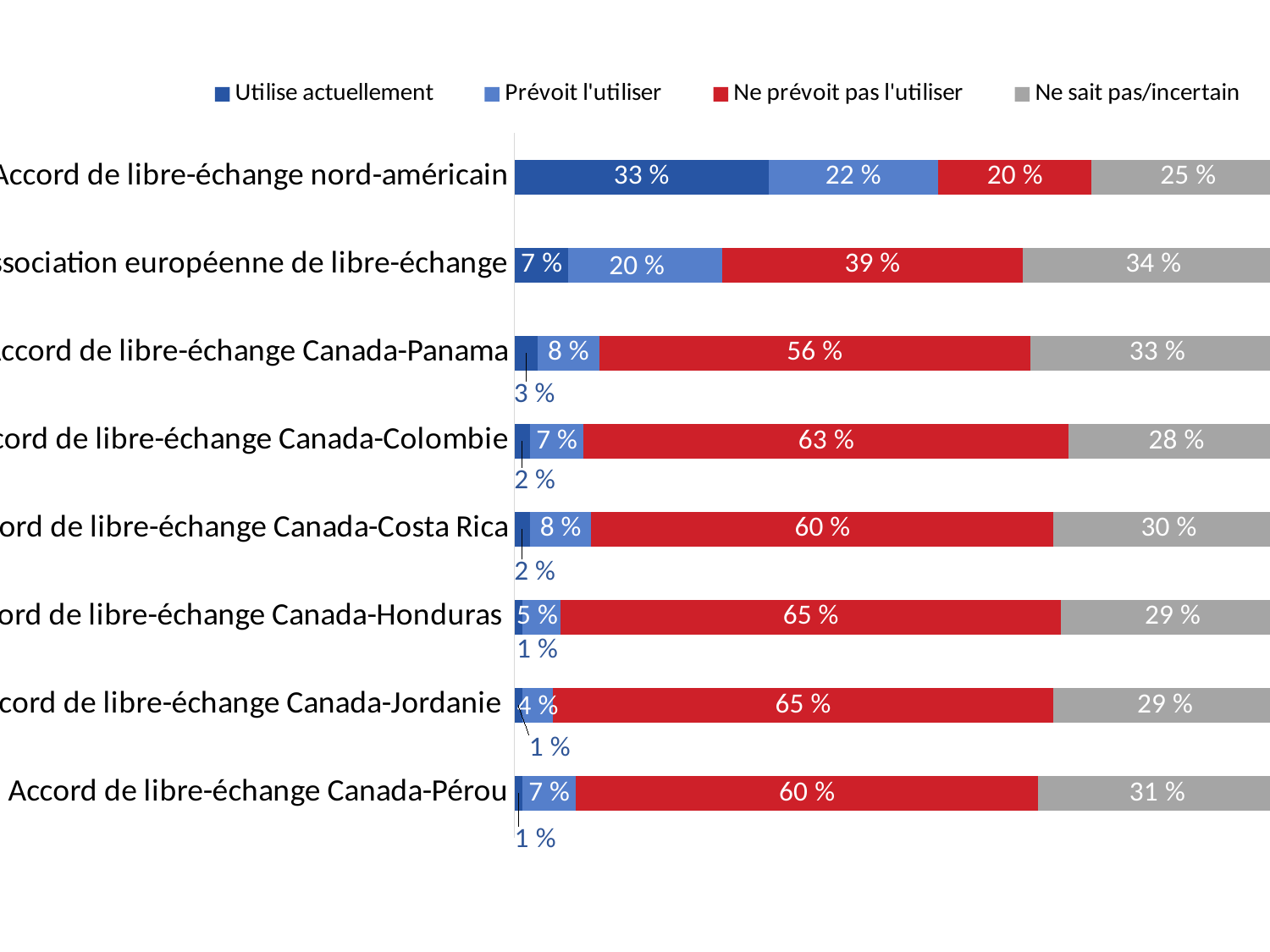
Which agreement has the lowest "Ne prévoit pas l'utiliser" value? Accord de libre-échange nord-américain Which agreement has the highest "Utilise actuellement" value? Accord de libre-échange nord-américain What is the difference between the "Ne prévoit pas l'utiliser" values for Accord de libre-échange Canada-Honduras and Association européenne de libre-échange? 26 % What type of chart is shown on the slide? Stacked bar chart Which legend entry is shown in red? Ne prévoit pas l'utiliser How many series does the legend list? 4 What is the value of "Prévoit l'utiliser" for Accord de libre-échange Canada-Panama? 8 % What is the value of "Utilise actuellement" for Accord de libre-échange nord-américain? 33 % What is the value of "Ne prévoit pas l'utiliser" for Accord de libre-échange Canada-Colombie? 63 % Which is larger: the "Ne sait pas/incertain" value for Accord de libre-échange Canada-Pérou or for Accord de libre-échange Canada-Colombie? Accord de libre-échange Canada-Pérou How many trade agreements (categories) are plotted in the chart? 8 What is the value of "Ne sait pas/incertain" for Association européenne de libre-échange? 34 %